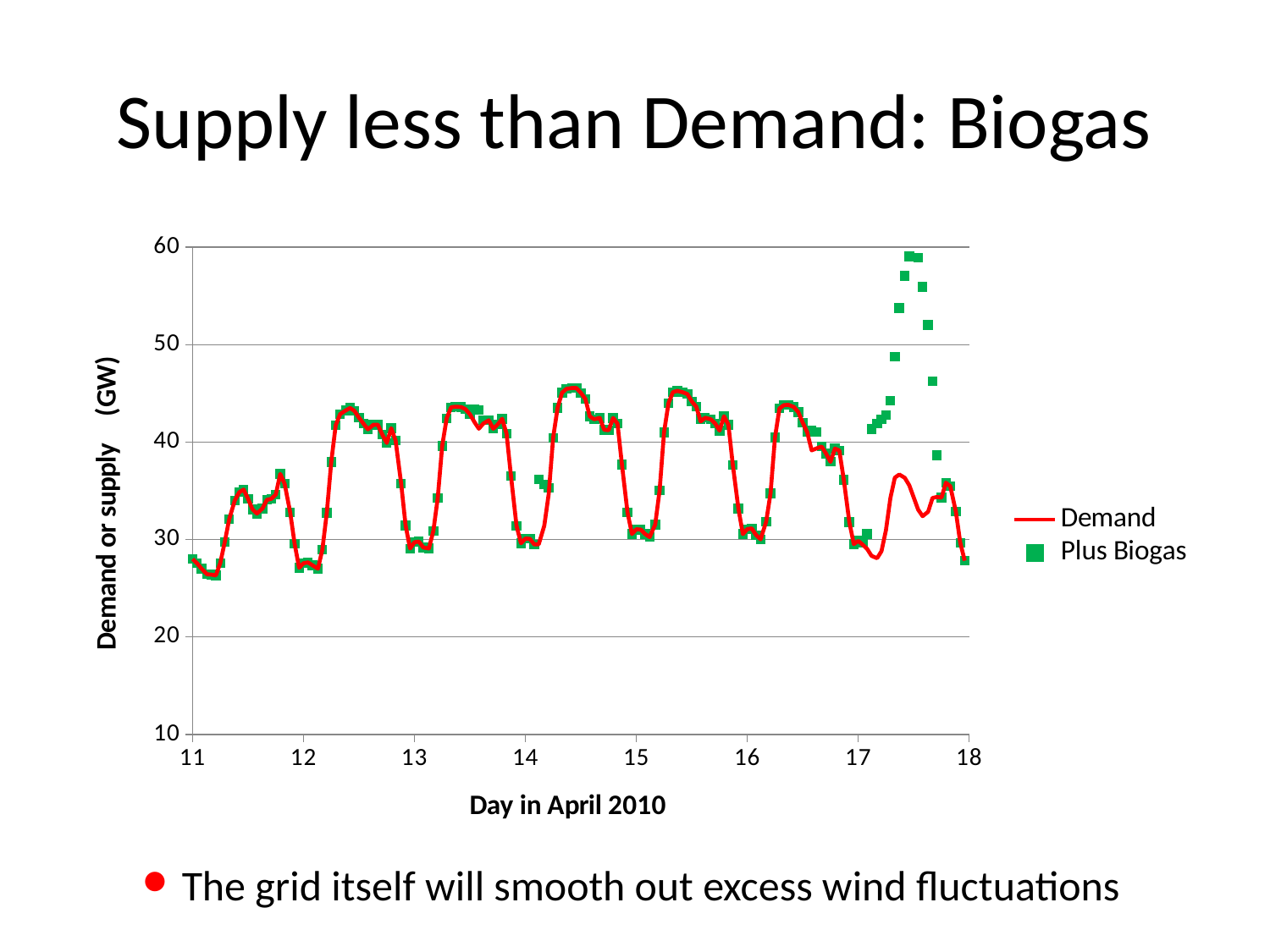
Does the Demand series rise or fall between day 17.5 and day 18? Fall Which is larger, the peak Demand on day 14 or the peak Demand on day 11? Peak Demand on day 14 What are the two series named in the chart legend? Demand and Plus Biogas How many series does the chart legend list? 2 Is the Demand value at day 18 greater or less than 30? less What kind of chart is shown on the slide? Line chart (with a scatter series) What is the label of the x axis of the chart? Day in April 2010 Around day 17.5, which series has the larger value, Demand or Plus Biogas? Plus Biogas Is the Demand value at day 11 greater or less than 30? less Is the peak Demand value on day 14 greater or less than 40? greater